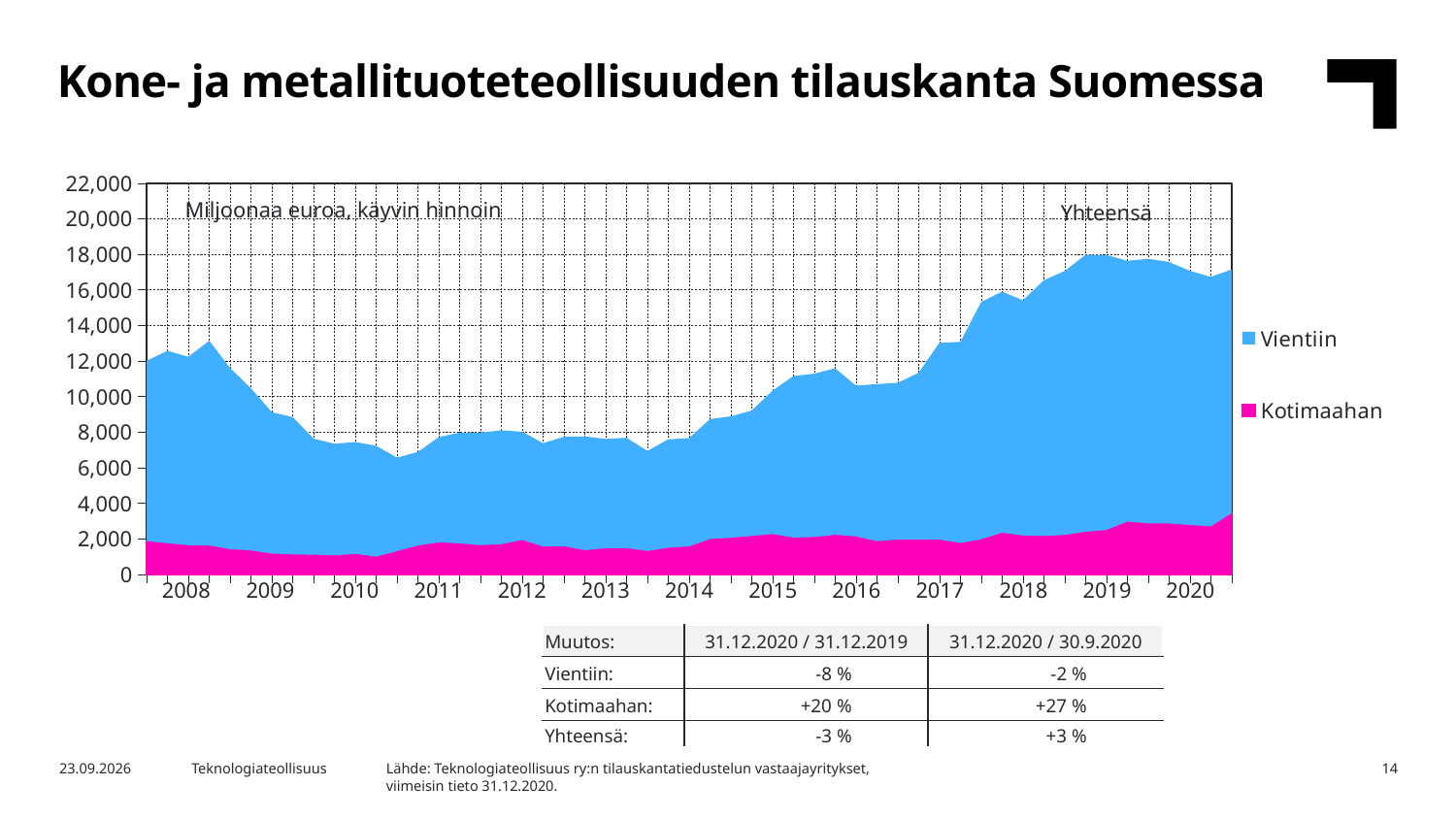
How many years are labelled on the x axis of the chart? 13 Is the Kotimaahan value at the end of 2020 greater or less than 2,000? greater What kind of chart is shown on the slide? Area chart Does the total order backlog rise or fall between 2008 and 2010? fall Is the total (Yhteensä) value at its 2019 peak greater or less than 16,000? greater Does the total order backlog rise or fall between 2013 and 2019? rise What unit is stated in the text inside the chart area? Miljoonaa euroa, käyvin hinnoin How many series does the chart legend list? 2 Is the Kotimaahan value in 2010 greater or less than 2,000? less Which series is larger throughout the chart, Vientiin or Kotimaahan? Vientiin What are the two series named in the chart legend? Vientiin and Kotimaahan